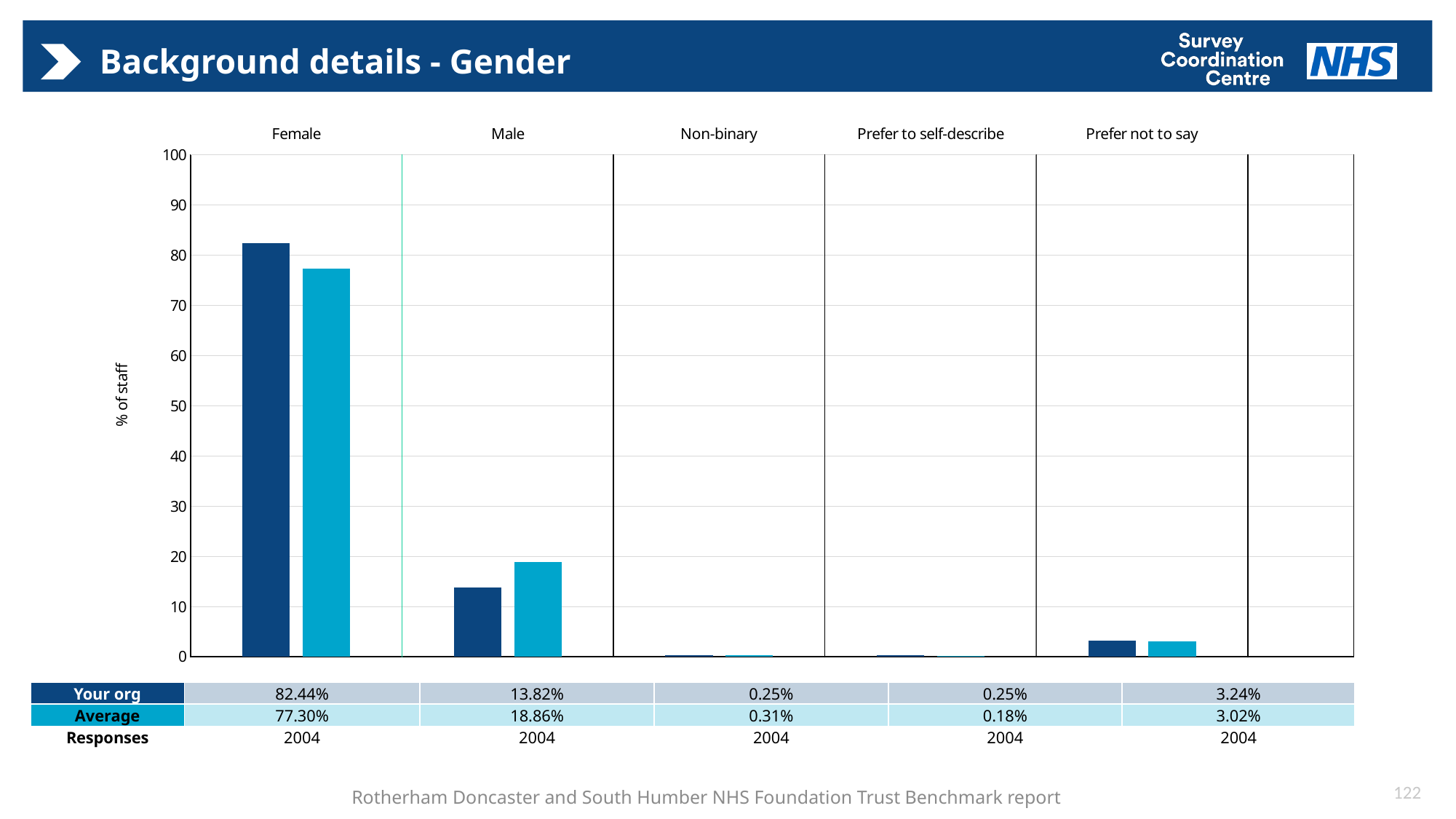
Is the 'Your org' bar for Female greater or less than 80? greater What is the difference between the 'Your org' and Average values for Female? 5.14% What is the Average value for Male? 18.86% What is the 'Your org' value for Female? 82.44% What is the 'Your org' value for Prefer not to say? 3.24% Which category has the lowest Average value? Prefer to self-describe For Male, which is larger: the 'Your org' value or the Average value? Average How many gender categories are shown on the chart? 5 How many series does the chart show? 2 What is the number of responses shown for Female? 2004 Which gender category has the highest 'Your org' value? Female What kind of chart is shown on the slide? Bar chart